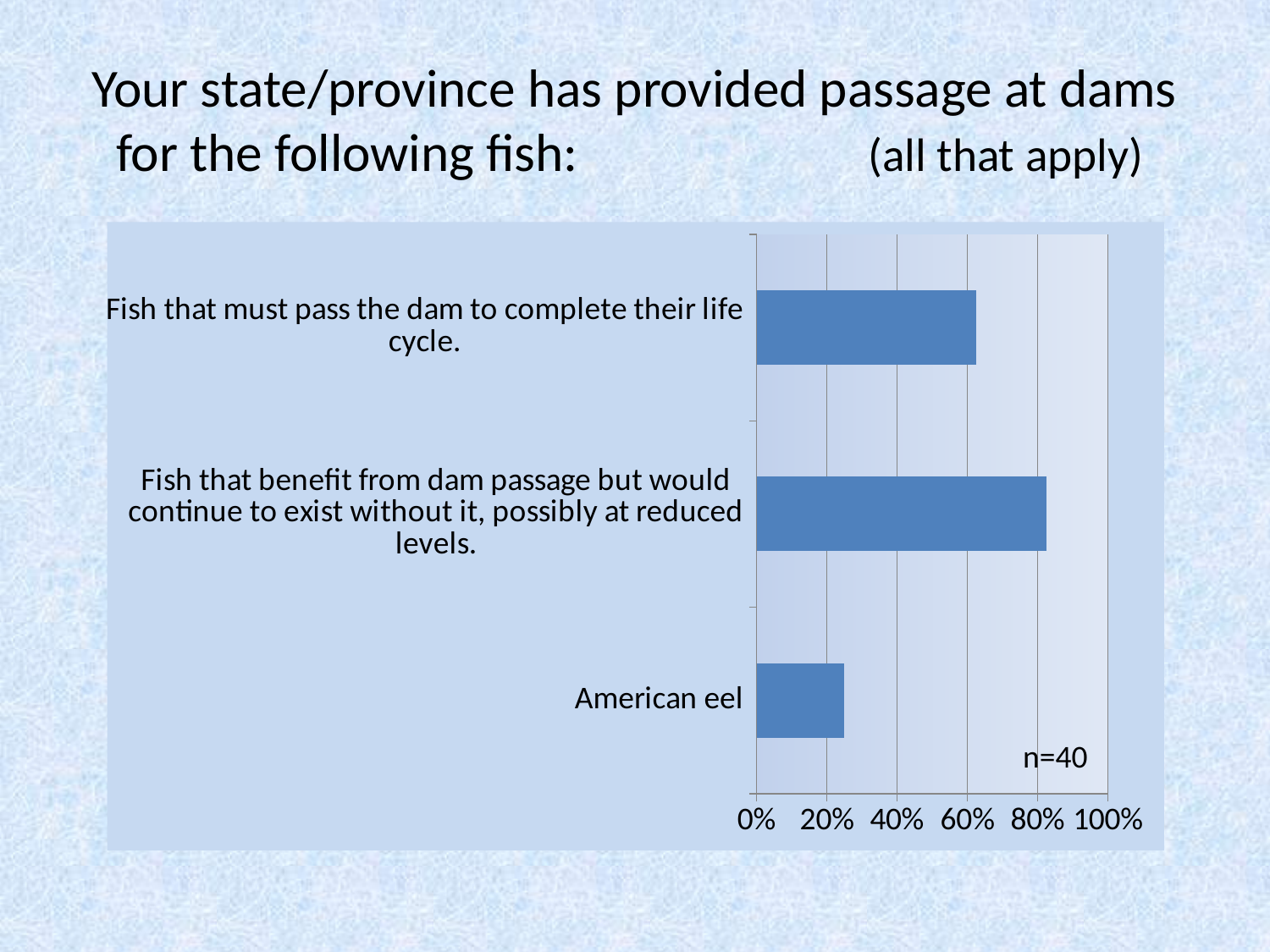
Which category has the highest value? Fish that benefit from dam passage but would continue to exist without it, possibly at reduced levels. Is the value for "Fish that must pass the dam to complete their life cycle." greater or less than 80%? less What is the highest value shown on the percentage axis? 100% Which has a larger value: "American eel" or "Fish that must pass the dam to complete their life cycle."? Fish that must pass the dam to complete their life cycle. Which category has the lowest value? American eel What sample size (n) is noted on the chart? n=40 What kind of chart is shown on the slide? bar chart Is the value for "Fish that must pass the dam to complete their life cycle." greater or less than 40%? greater How many categories are plotted in the chart? 3 Which has a larger value: "Fish that must pass the dam to complete their life cycle." or "Fish that benefit from dam passage but would continue to exist without it, possibly at reduced levels."? Fish that benefit from dam passage but would continue to exist without it, possibly at reduced levels. Is the value for "Fish that benefit from dam passage but would continue to exist without it, possibly at reduced levels." greater or less than 60%? greater